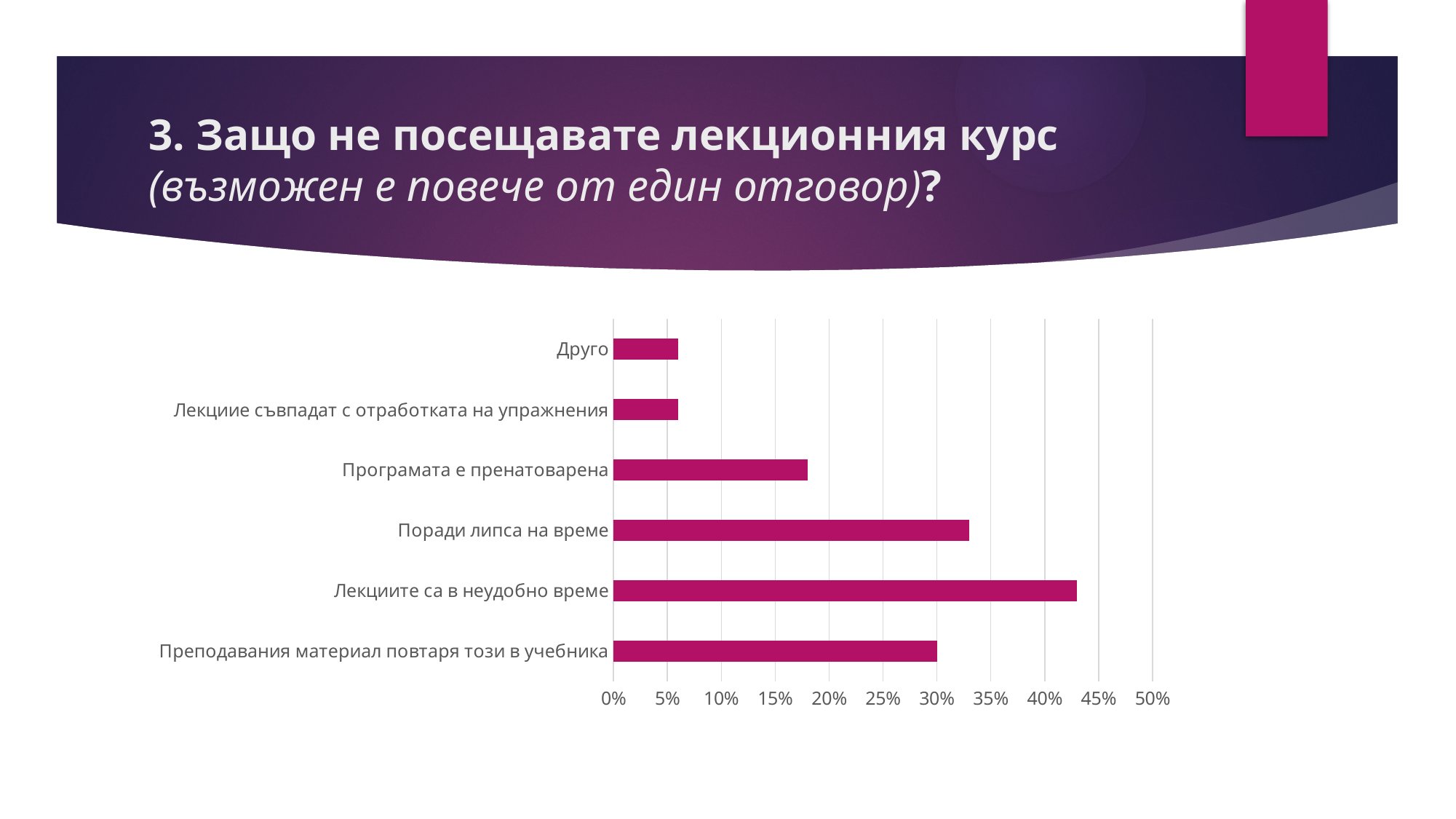
Which category has the highest value? Лекциите са в неудобно време What is the maximum value shown on the horizontal axis? 50% Which is larger, the value for Поради липса на време or the value for Програмата е пренатоварена? Поради липса на време Is the value for Преподавания материал повтаря този в учебника greater or less than 25%? greater Is the value for Друго greater or less than 10%? less Is the value for Лекциите са в неудобно време greater or less than 40%? greater What colour are the bars in the chart? magenta Which is larger, the value for Лекциите са в неудобно време or the value for Преподавания материал повтаря този в учебника? Лекциите са в неудобно време What kind of chart is shown on the slide? bar chart How many categories does the chart show? 6